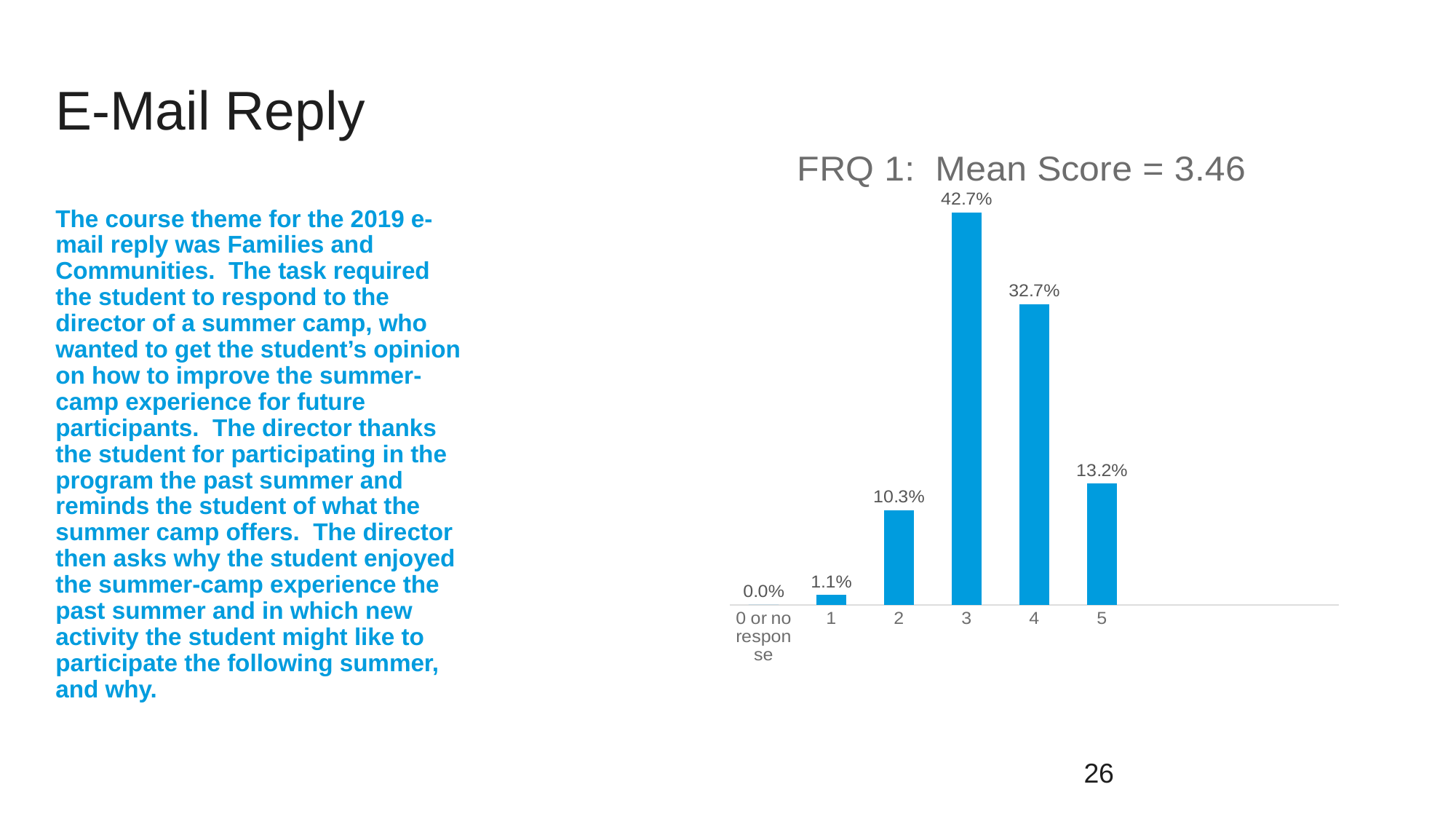
What is the difference in percentage points between score 2 and score 5? 2.9% What percentage of responses received a score of 1? 1.1% Which score category has the highest percentage? 3 What percentage of responses received a score of 3? 42.7% What is the difference in percentage points between score 3 and score 4? 10.0% What kind of chart is shown on the slide? Bar chart What percentage of responses received a score of 5? 13.2% What percentage is shown for the '0 or no response' category? 0.0% Which score category has the lowest percentage? 0 or no response Which has a larger percentage, score 4 or score 5? 4 How many score categories are shown on the x axis? 6 What is the mean score stated in the chart title? 3.46